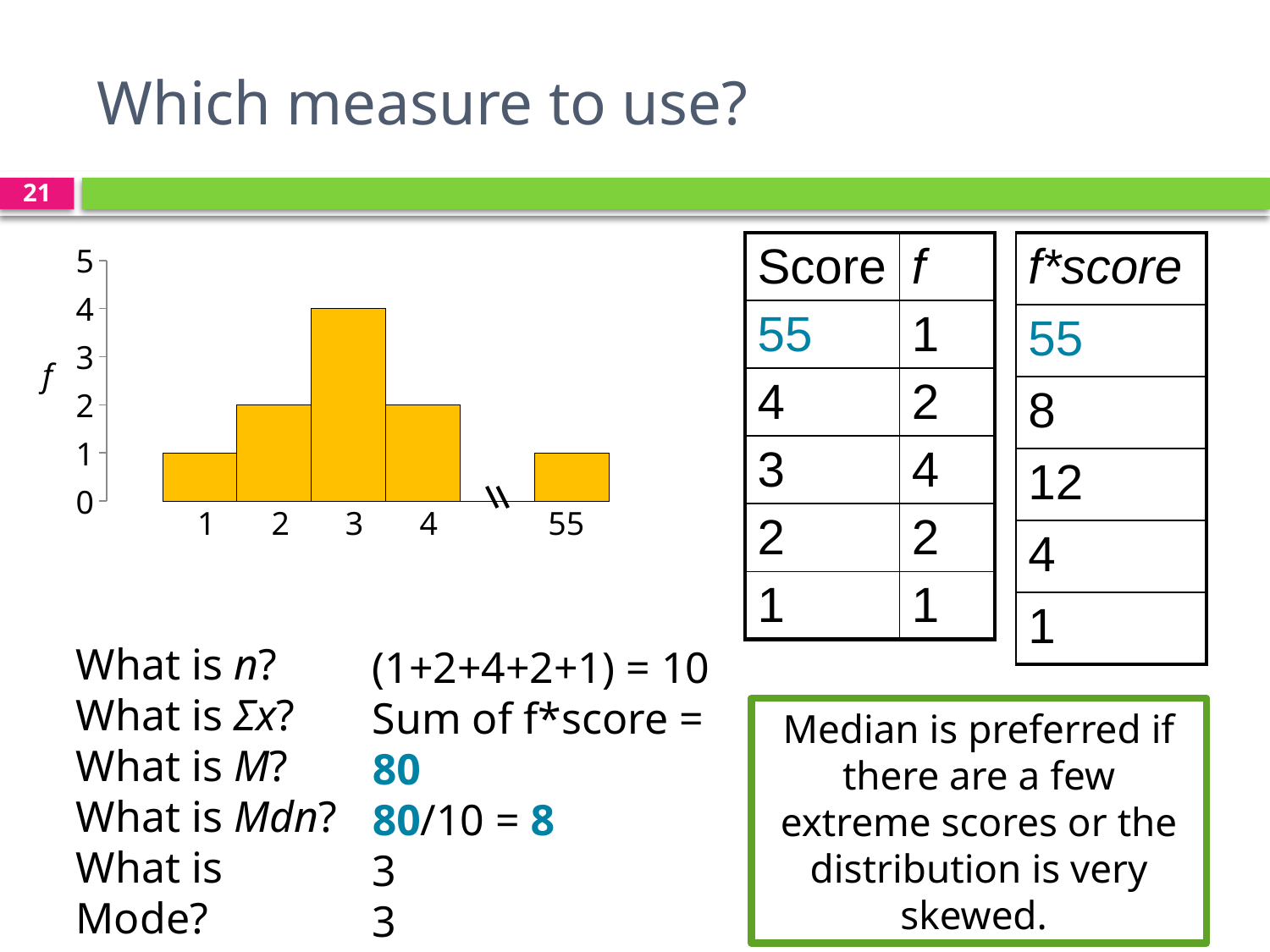
Which score has the highest frequency in the chart? 3 What is the difference in frequency between score 3 and score 4? 2 What type of chart is shown on the slide? bar chart What is the frequency (f) for score 3 in the chart? 4 How many bars are plotted in the chart? 5 What is the frequency (f) for score 55 in the chart? 1 Do the frequencies rise or fall from score 1 to score 3 in the chart? rise What is the frequency (f) for score 2 in the chart? 2 What is the label on the y axis of the chart? f Is the frequency for score 3 greater or less than 2? greater What is the highest value shown on the y axis of the chart? 5 Which has a larger frequency, score 2 or score 3? 3